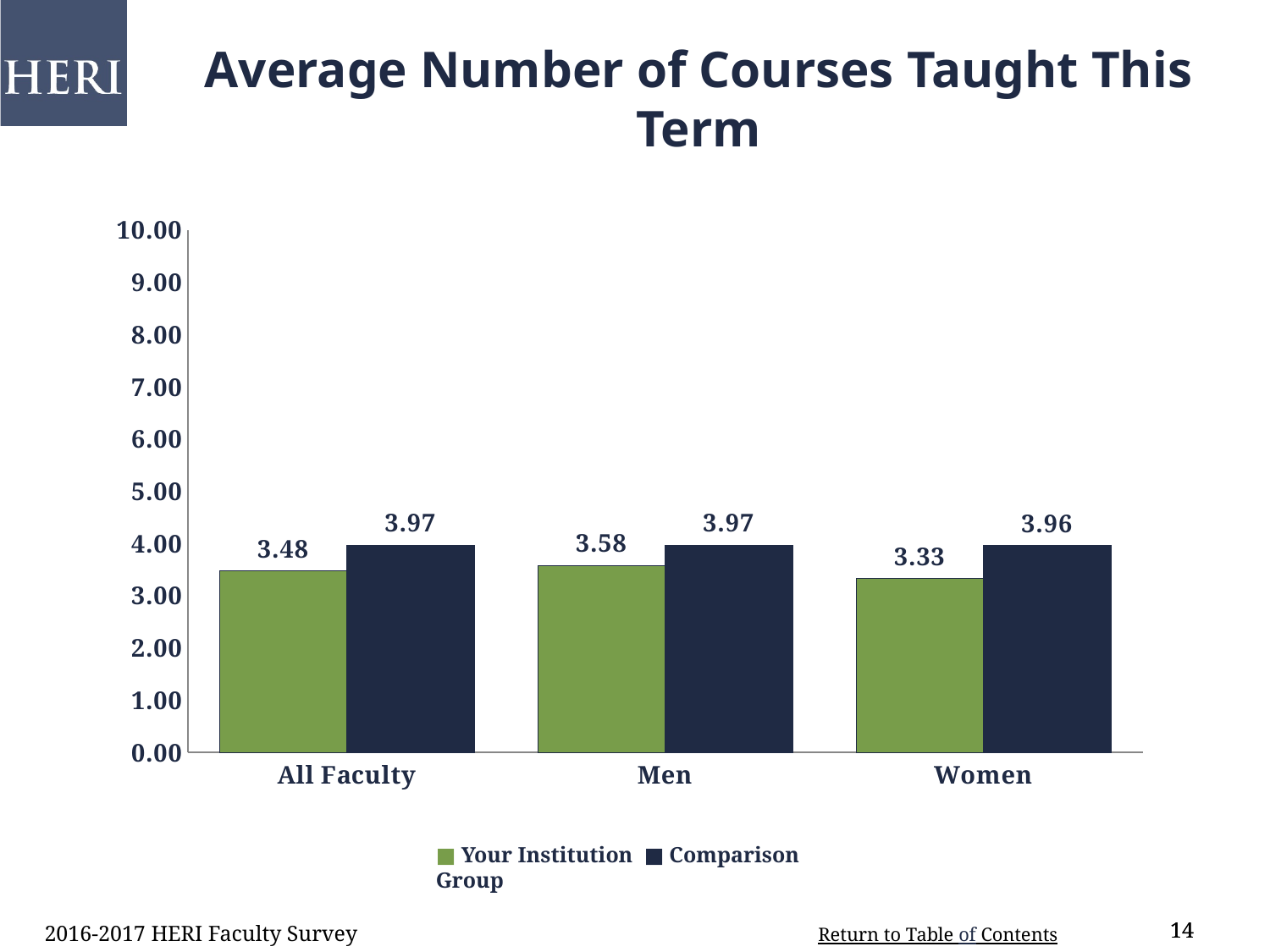
What is the difference between the Comparison Group and Your Institution values for Women? 0.63 What is the value for Your Institution in the Men category? 3.58 How many series does the legend list? 2 What is the difference between the Your Institution values for Men and Women? 0.25 Which category has the lowest value for Your Institution? Women Is the value for Your Institution in the Women category greater or less than 4.00? less How many categories are shown on the x axis? 3 Which is larger for All Faculty: Your Institution or Comparison Group? Comparison Group What is the value for Your Institution in the All Faculty category? 3.48 What kind of chart is shown on the slide? bar chart What is the value for Comparison Group in the Women category? 3.96 Which category has the highest value for Your Institution? Men